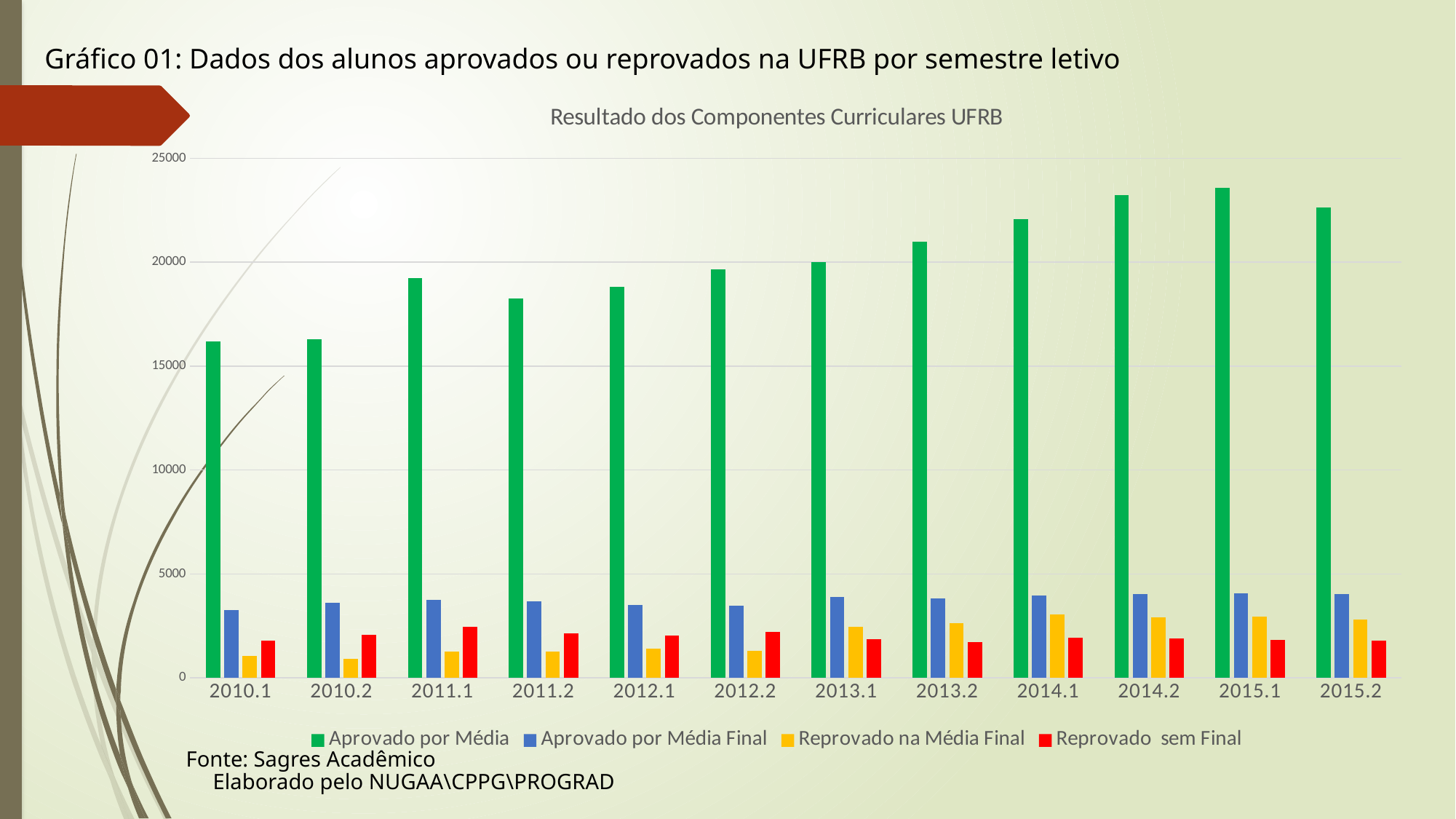
In which semester is the value for 'Aprovado por Média' the highest? 2015.1 Which colour represents the series 'Aprovado por Média' in the chart? Green What is the title of the chart? Resultado dos Componentes Curriculares UFRB Is the value for 'Aprovado por Média' in 2010.1 greater or less than 15000? greater How many series does the chart's legend list? 4 Is the value for 'Aprovado por Média Final' in 2015.1 greater or less than 5000? less How many semesters (categories) are shown on the x axis of the chart? 12 Overall, does the value for 'Aprovado por Média' rise or fall from 2010.1 to 2015.1? Rise What kind of chart is shown on the slide? Bar chart In which semester is the value for 'Reprovado sem Final' the highest? 2011.1 Is the value for 'Aprovado por Média' in 2014.1 greater or less than 20000? greater Which is larger, the value for 'Aprovado por Média' in 2011.1 or in 2011.2? 2011.1